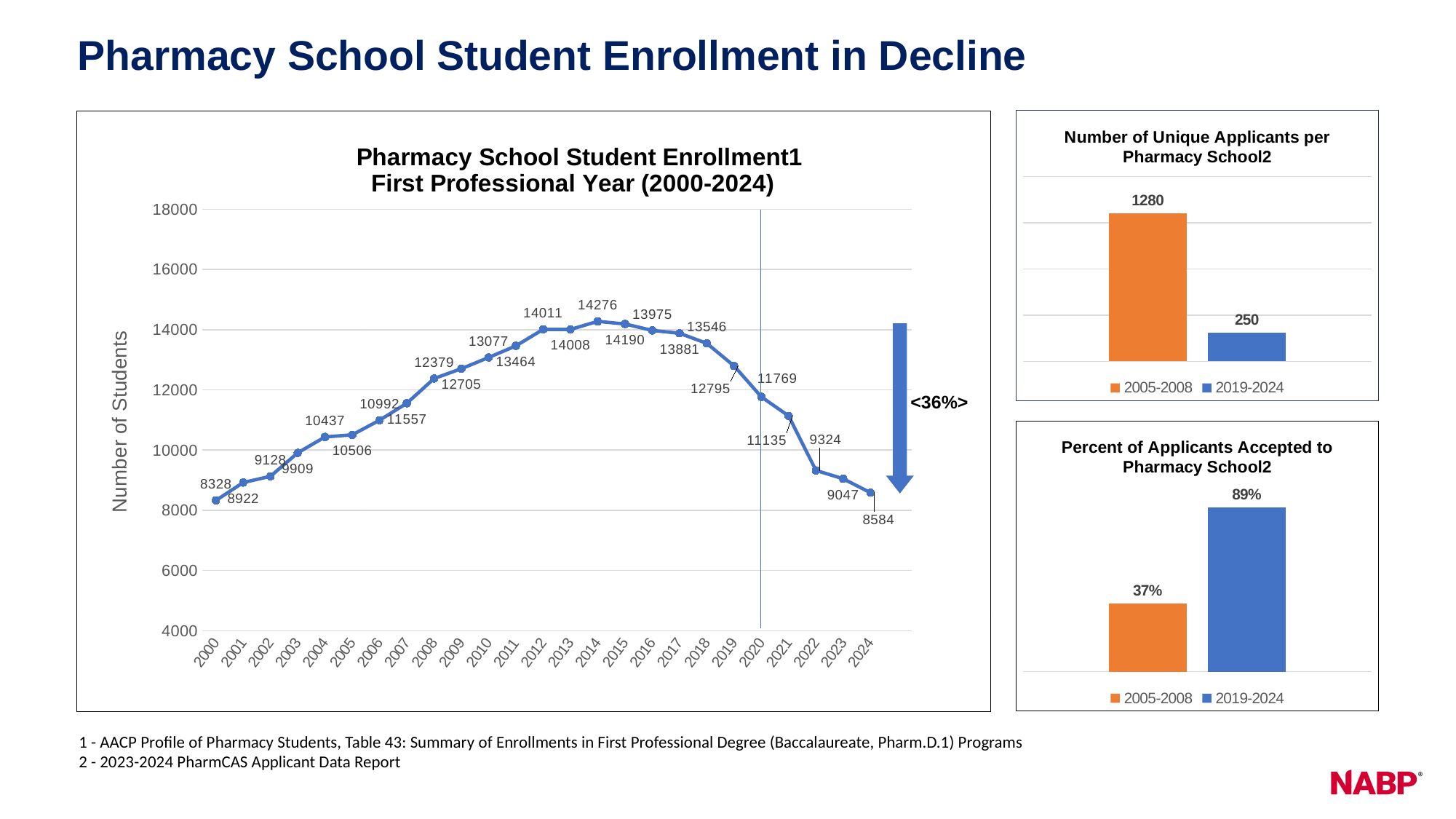
What kind of chart is 'Percent of Applicants Accepted to Pharmacy School'? bar chart In the line chart 'Pharmacy School Student Enrollment First Professional Year (2000-2024)', which year had the highest enrollment? 2014 In the line chart 'Pharmacy School Student Enrollment First Professional Year (2000-2024)', what was the enrollment in 2014? 14276 In the chart 'Percent of Applicants Accepted to Pharmacy School', what is the value for 2019-2024? 89% In the line chart 'Pharmacy School Student Enrollment First Professional Year (2000-2024)', how many years are plotted? 25 In the line chart 'Pharmacy School Student Enrollment First Professional Year (2000-2024)', does enrollment rise or fall from 2014 to 2024? fall In the line chart 'Pharmacy School Student Enrollment First Professional Year (2000-2024)', which is larger, the enrollment in 2008 or in 2021? 2008 In the line chart 'Pharmacy School Student Enrollment First Professional Year (2000-2024)', what is the difference between the 2014 enrollment and the 2024 enrollment? 5692 In the line chart 'Pharmacy School Student Enrollment First Professional Year (2000-2024)', what was the enrollment in 2024? 8584 In the line chart 'Pharmacy School Student Enrollment First Professional Year (2000-2024)', which year had the lowest enrollment? 2000 In the chart 'Number of Unique Applicants per Pharmacy School', what is the value for 2005-2008? 1280 In the chart 'Number of Unique Applicants per Pharmacy School', what is the difference between the 2005-2008 value and the 2019-2024 value? 1030